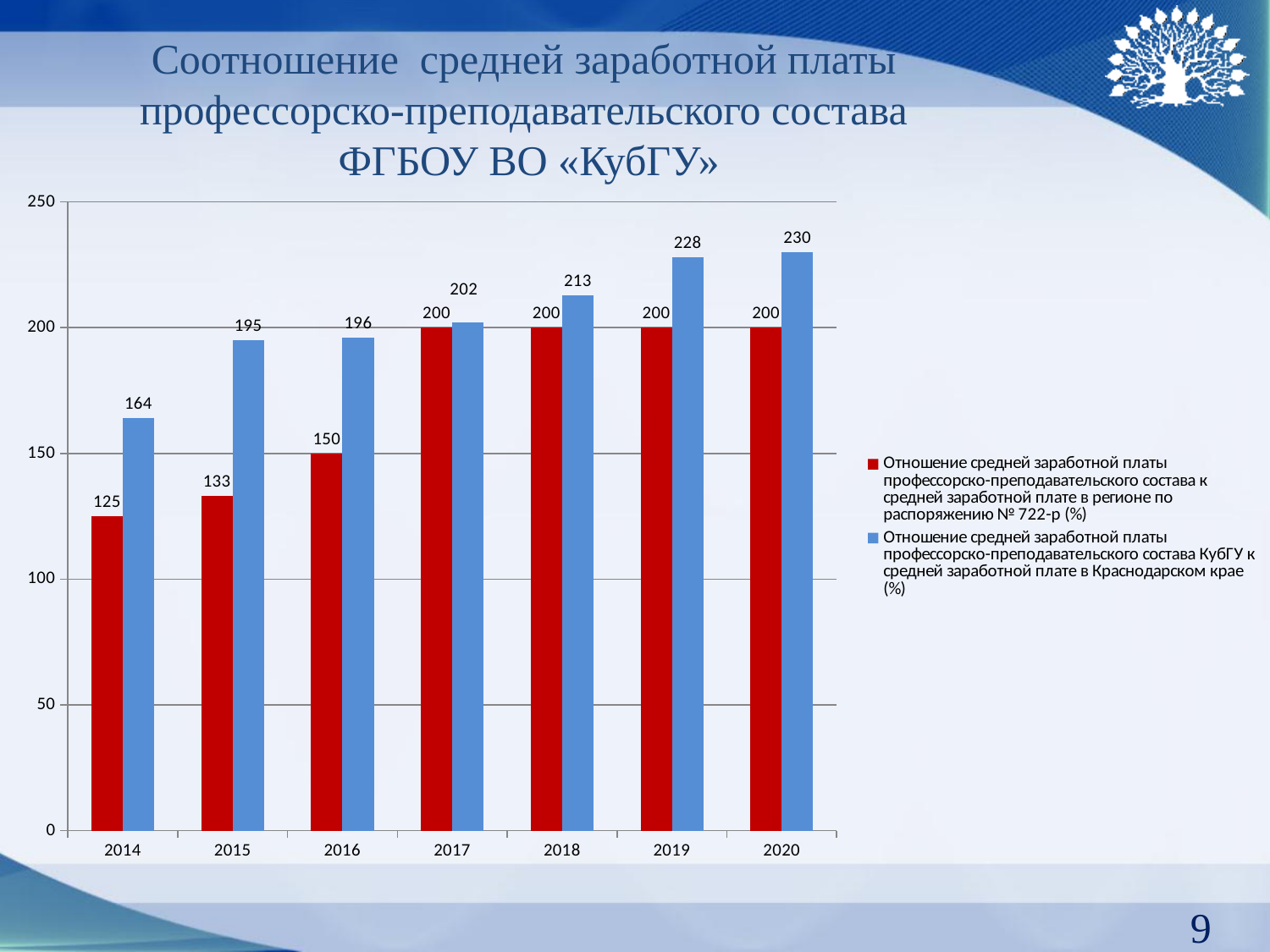
In which year is the blue series (KubGU ratio to Krasnodar region average salary) highest? 2020 How many series does the legend list? 2 Which is larger in 2015: the red series value or the blue series value? the blue series (195) What kind of chart is shown on the slide? bar chart Is the blue series value for 2018 greater or less than 200? greater What is the value of the blue series (KubGU ratio to Krasnodar region average salary) for 2020? 230 What is the value of the red series (ratio per order № 722-р) for 2014? 125 In which year is the red series (ratio per order № 722-р) lowest? 2014 Does the blue series rise or fall from 2014 to 2020? rise How many years are shown on the x axis? 7 What is the difference between the blue and red series values in 2019? 28 What is the value of the blue series (KubGU ratio to Krasnodar region average salary) for 2016? 196